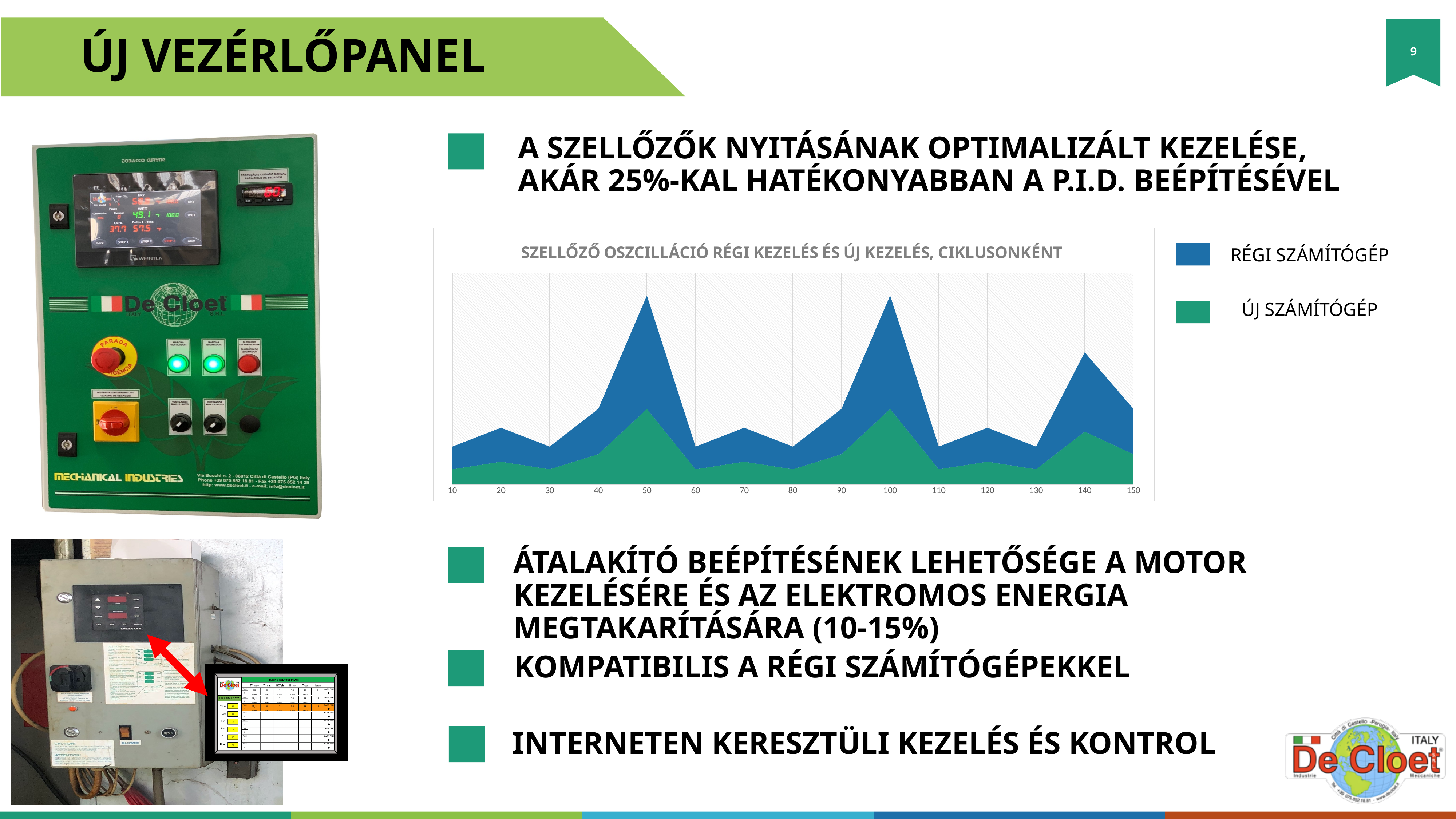
How many series does the chart's legend list? 2 How many points are plotted along the x axis of the chart? 15 At x = 140, which series has the larger value, RÉGI SZÁMÍTÓGÉP or ÚJ SZÁMÍTÓGÉP? RÉGI SZÁMÍTÓGÉP For the RÉGI SZÁMÍTÓGÉP series, which is larger: the value at 50 or the value at 140? 50 Which series is shown in blue in the chart? RÉGI SZÁMÍTÓGÉP What kind of chart is shown on the slide? area chart For the RÉGI SZÁMÍTÓGÉP series, which is larger: the value at 100 or the value at 110? 100 Does the RÉGI SZÁMÍTÓGÉP series rise or fall between x = 50 and x = 60? fall What is the title of the chart? SZELLŐZŐ OSZCILLÁCIÓ RÉGI KEZELÉS ÉS ÚJ KEZELÉS, CIKLUSONKÉNT Does the ÚJ SZÁMÍTÓGÉP series rise or fall between x = 130 and x = 140? rise What is the first x-axis tick label on the chart? 10